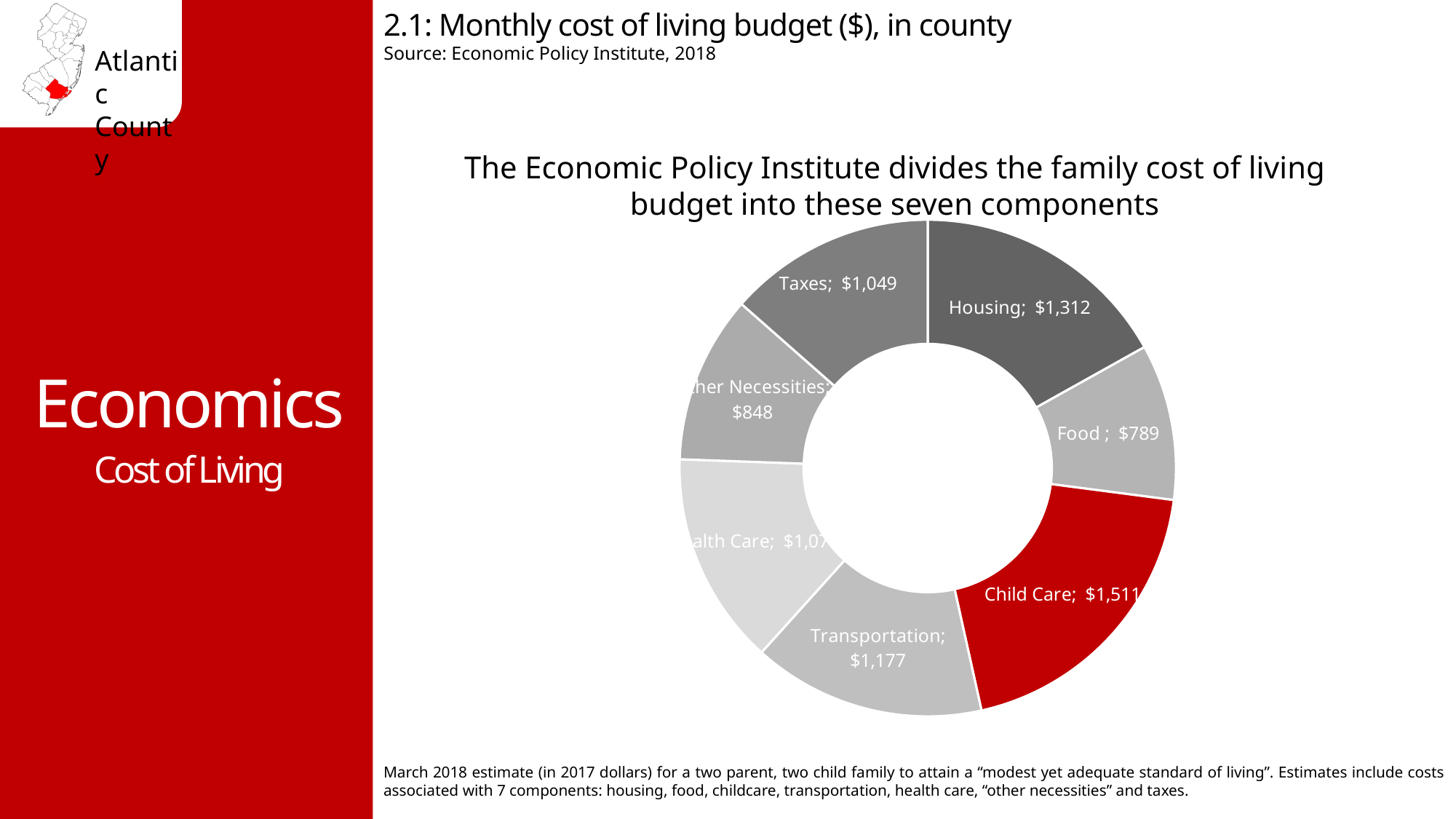
How many components are shown in the chart? 7 What is the monthly cost for Housing shown on the chart? $1,312 Which component has the lowest monthly cost in the chart? Food What is the monthly cost for Child Care shown on the chart? $1,511 Which component has the highest monthly cost in the chart? Child Care What type of chart is used on this slide? Doughnut (pie) chart What is the monthly cost for Other Necessities shown on the chart? $848 How much more does Child Care cost per month than Housing? $199 Which is larger, the monthly cost for Taxes or for Transportation? Transportation What is the monthly cost for Transportation shown on the chart? $1,177 What is the monthly cost for Food shown on the chart? $789 What is the monthly cost for Taxes shown on the chart? $1,049